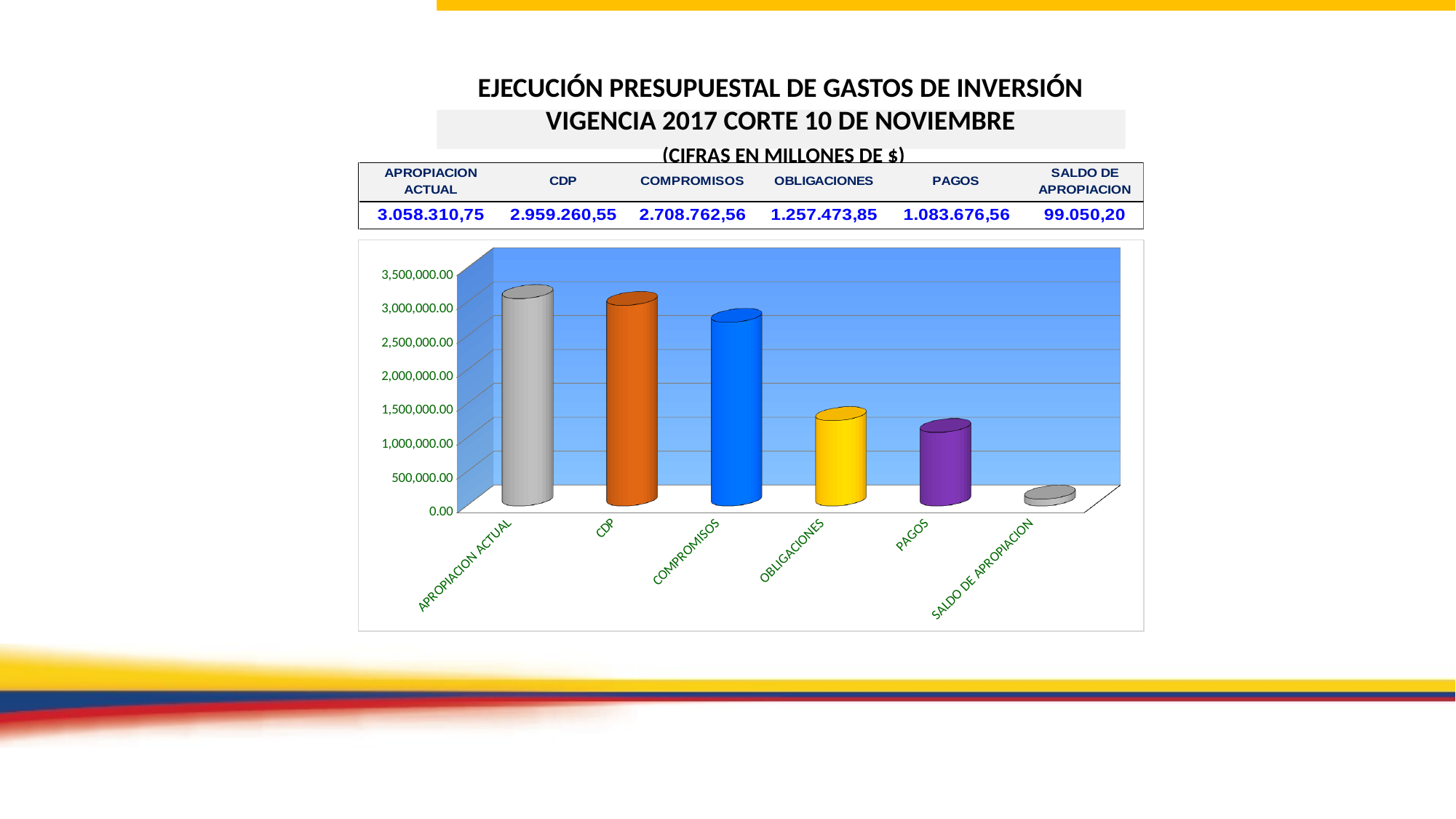
Which category has the lowest value? SALDO DE APROPIACION Is the value for PAGOS greater or less than 1,000,000.00? greater Which is larger, CDP or COMPROMISOS? CDP Do the values rise or fall from left to right along the x axis? fall What is the value for PAGOS? 1.083.676,56 What is the value for SALDO DE APROPIACION? 99.050,20 What is the difference between OBLIGACIONES and PAGOS? 173.797,29 What is the value for APROPIACION ACTUAL? 3.058.310,75 What kind of chart is shown on the slide? bar chart Which category has the highest value? APROPIACION ACTUAL What is the difference between APROPIACION ACTUAL and CDP? 99.050,20 How many categories are shown in the chart? 6